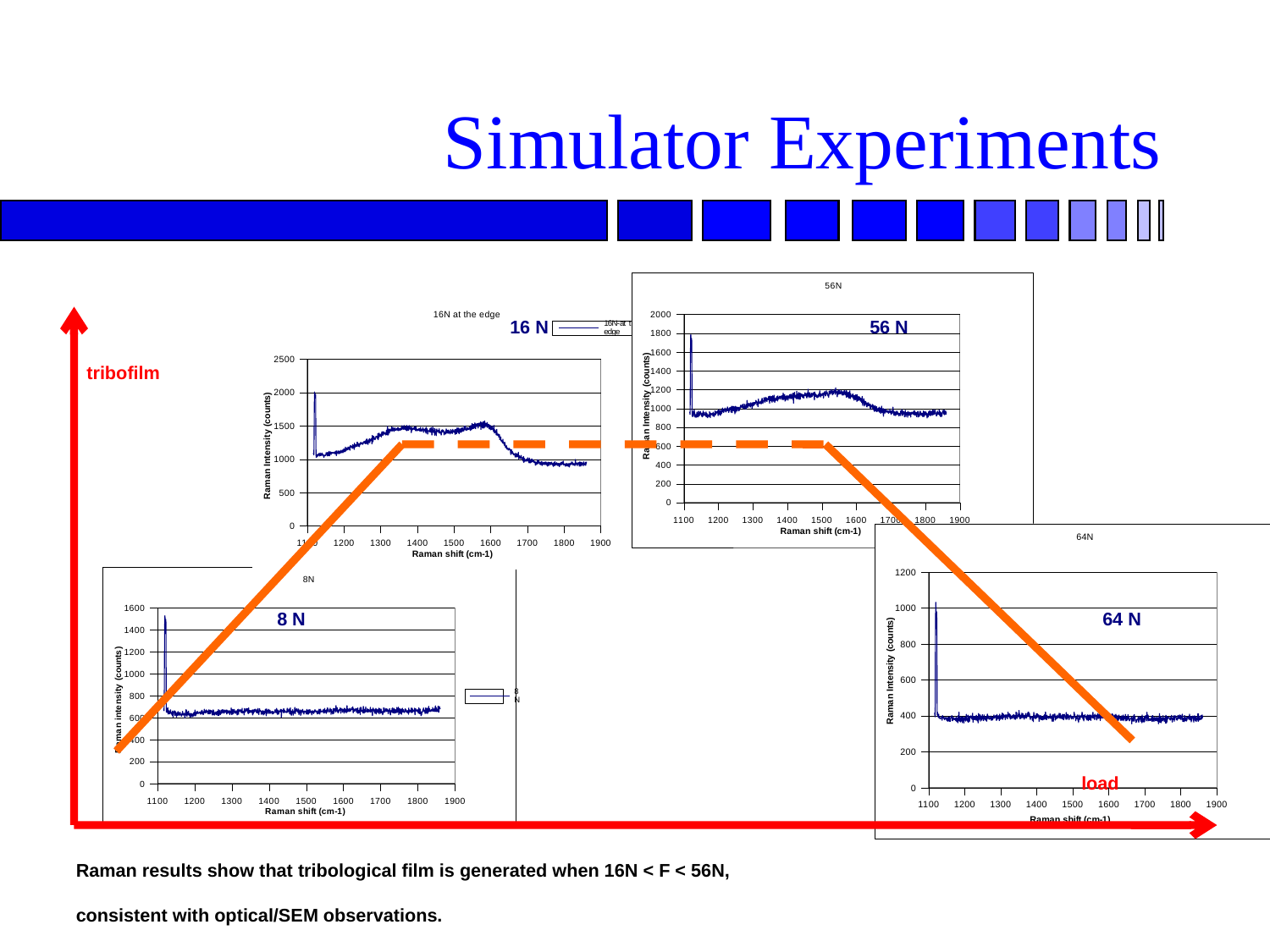
In the chart titled "8N", is the Raman intensity at a Raman shift of 1500 greater or less than 1000? less What is the x-axis label of the chart titled "64N"? Raman shift (cm-1) In the chart titled "16N at the edge", is the Raman intensity at a Raman shift of 1800 greater or less than 1500? less In the chart titled "64N", is the Raman intensity at a Raman shift of 1500 greater or less than 800? less In the chart titled "16N at the edge", do the values rise or fall between Raman shifts of 1600 and 1700? fall In the chart titled "56N", is the Raman intensity at a Raman shift of 1500 greater or less than the intensity at 1800? greater What legend entry is shown in the chart titled "16N at the edge"? 16N-at the edge What kind of chart is the one titled "8N"? line chart How many charts are shown on the slide? 4